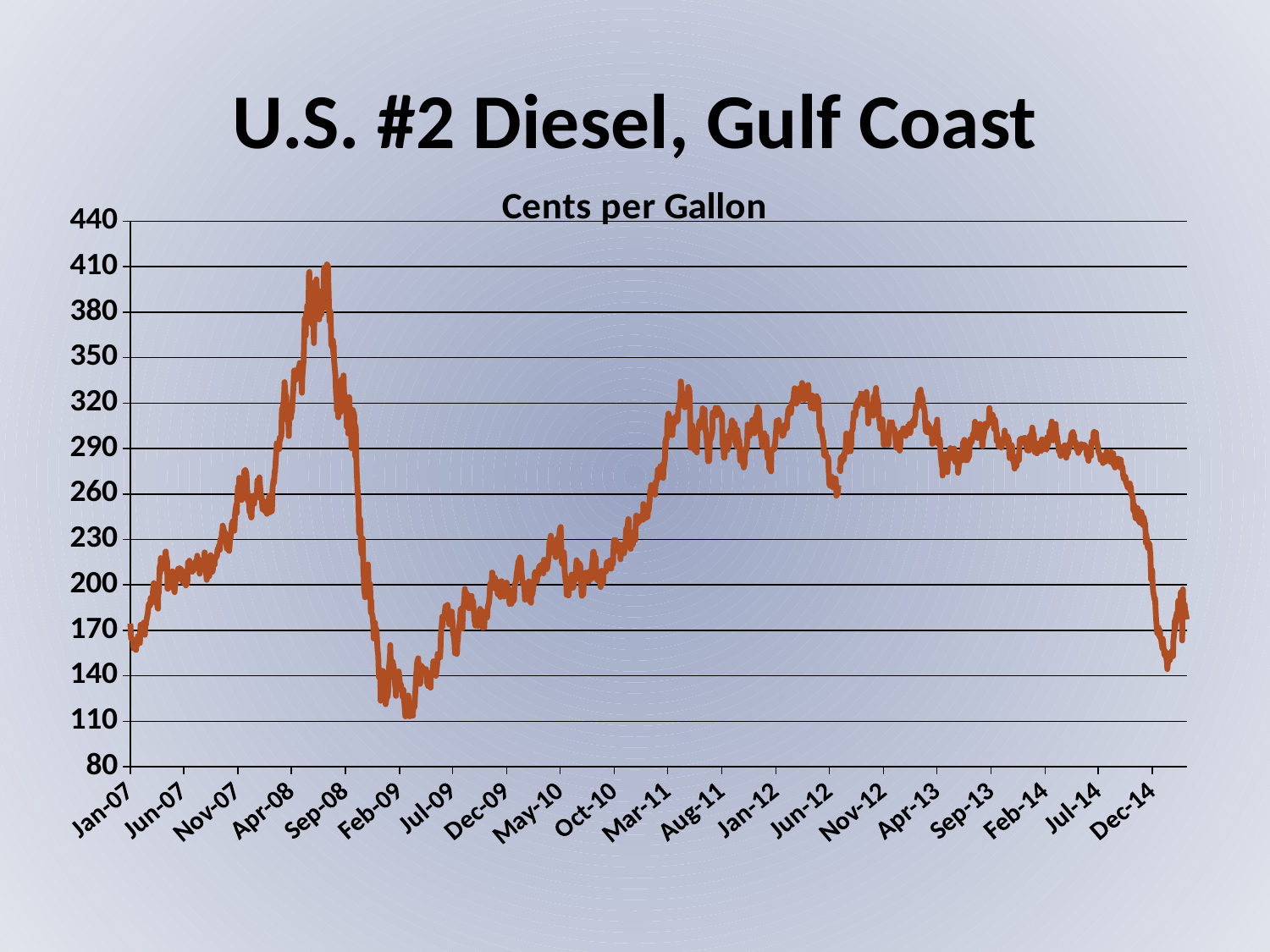
In which year does the line reach its highest point? 2008 In which year does the line reach its lowest point? 2009 Is the value around Feb-09 greater or less than 200? less Do values rise or fall between Sep-08 and Feb-09? fall What unit is the diesel price plotted in, according to the chart subtitle? Cents per Gallon Is the lowest value reached by the line greater or less than 140? less What kind of chart is shown on the slide? line chart What is the title of the chart? Cents per Gallon Is the value around Jan-12 greater or less than 260? greater How many date labels are shown along the x axis? 20 Which is higher, the value around Jan-07 or the value around Jan-12? Jan-12